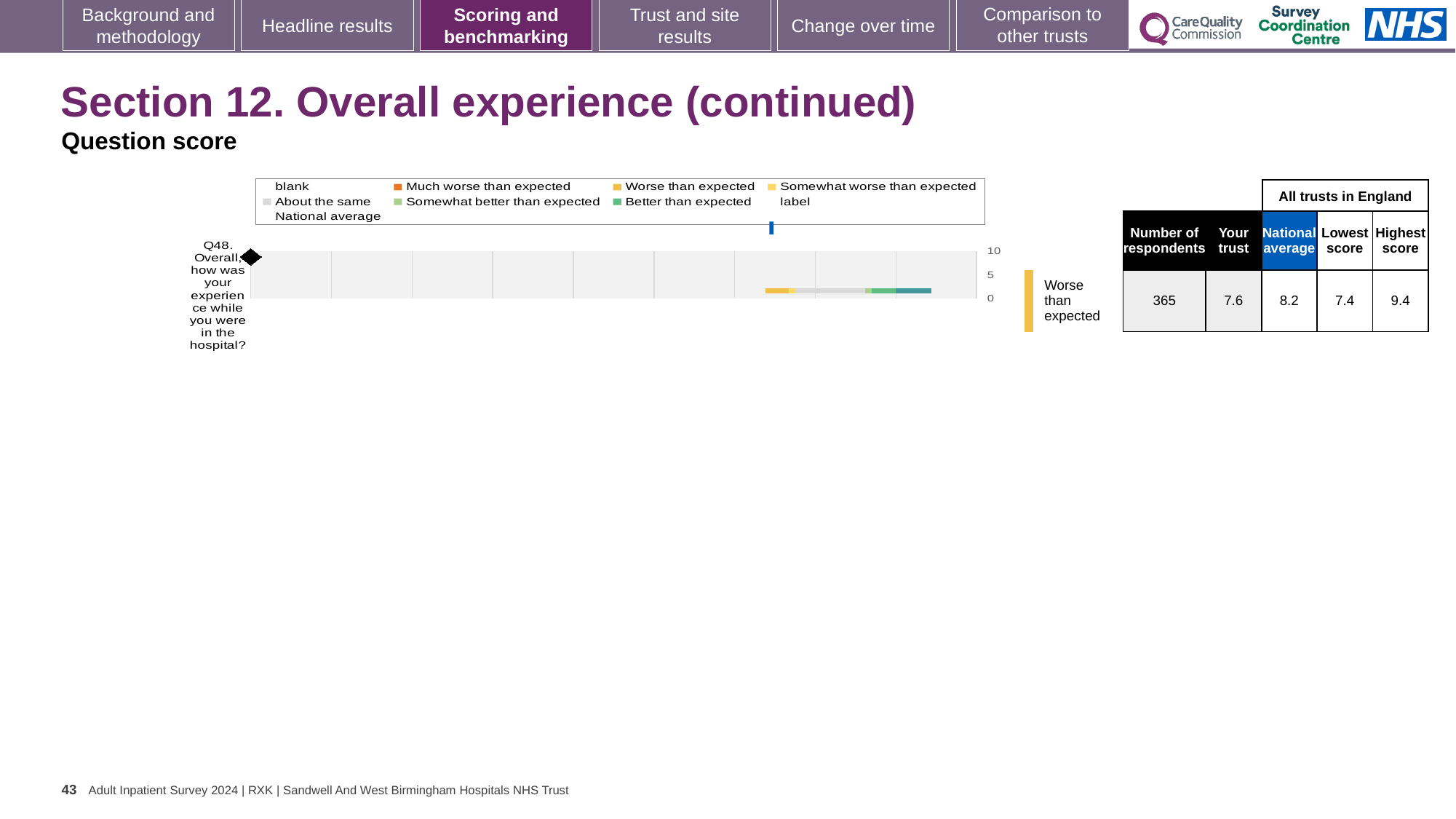
Which is larger for Q48, the Your trust score or the National average score? National average What is the difference between the National average score and the Your trust score for Q48? 0.6 According to the table beside the chart, how many respondents answered Q48? 365 What benchmark rating is shown next to the chart for Q48? Worse than expected How many questions (categories) are plotted in the chart? 1 According to the table beside the chart, what is the Lowest score among all trusts in England for Q48? 7.4 Which question is plotted in the chart? Q48. Overall, how was your experience while you were in the hospital? What kind of chart is shown for Q48 on this slide? bar chart According to the table beside the chart, what is the score for Your trust on Q48? 7.6 According to the table beside the chart, what is the Highest score among all trusts in England for Q48? 9.4 What is the difference between the Highest score and the Lowest score for Q48? 2.0 According to the table beside the chart, what is the National average score for Q48? 8.2